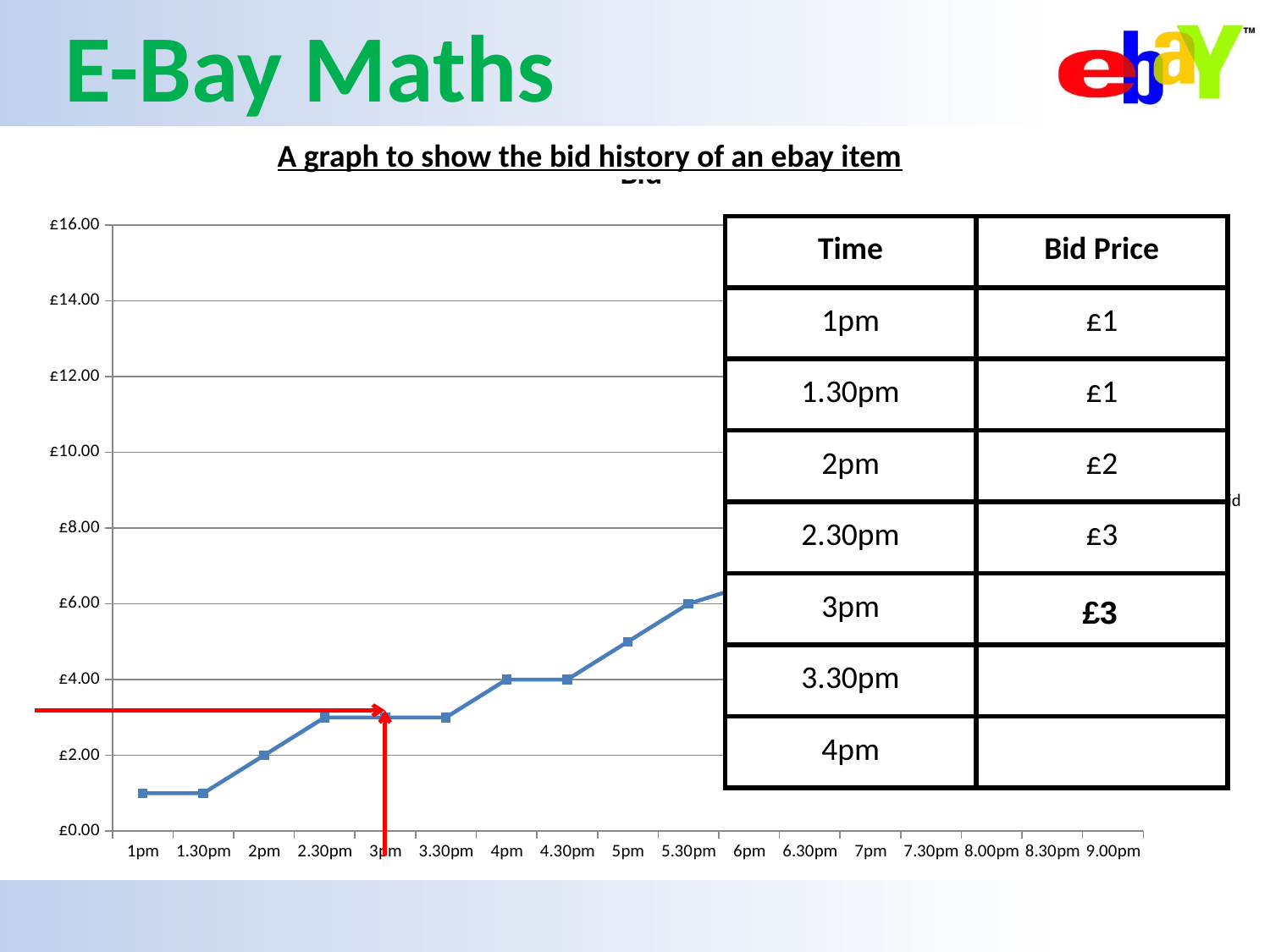
What was the bid price at 1pm? £1 Which is larger, the bid at 2pm or the bid at 5.30pm? 5.30pm What is the difference between the bid price at 2.30pm and the bid price at 1pm? £2 What is the title of the graph? A graph to show the bid history of an ebay item What bid value does the point at 5.30pm land on? £6.00 What was the bid price at 3pm? £3 What kind of chart is shown on the slide? line chart What bid value does the point at 4pm land on? £4.00 What was the bid price at 2.30pm? £3 Is the bid value at 3.30pm greater or less than £4.00? less How many time labels are shown along the x axis? 17 Is the bid value at 5pm greater or less than £4.00? greater